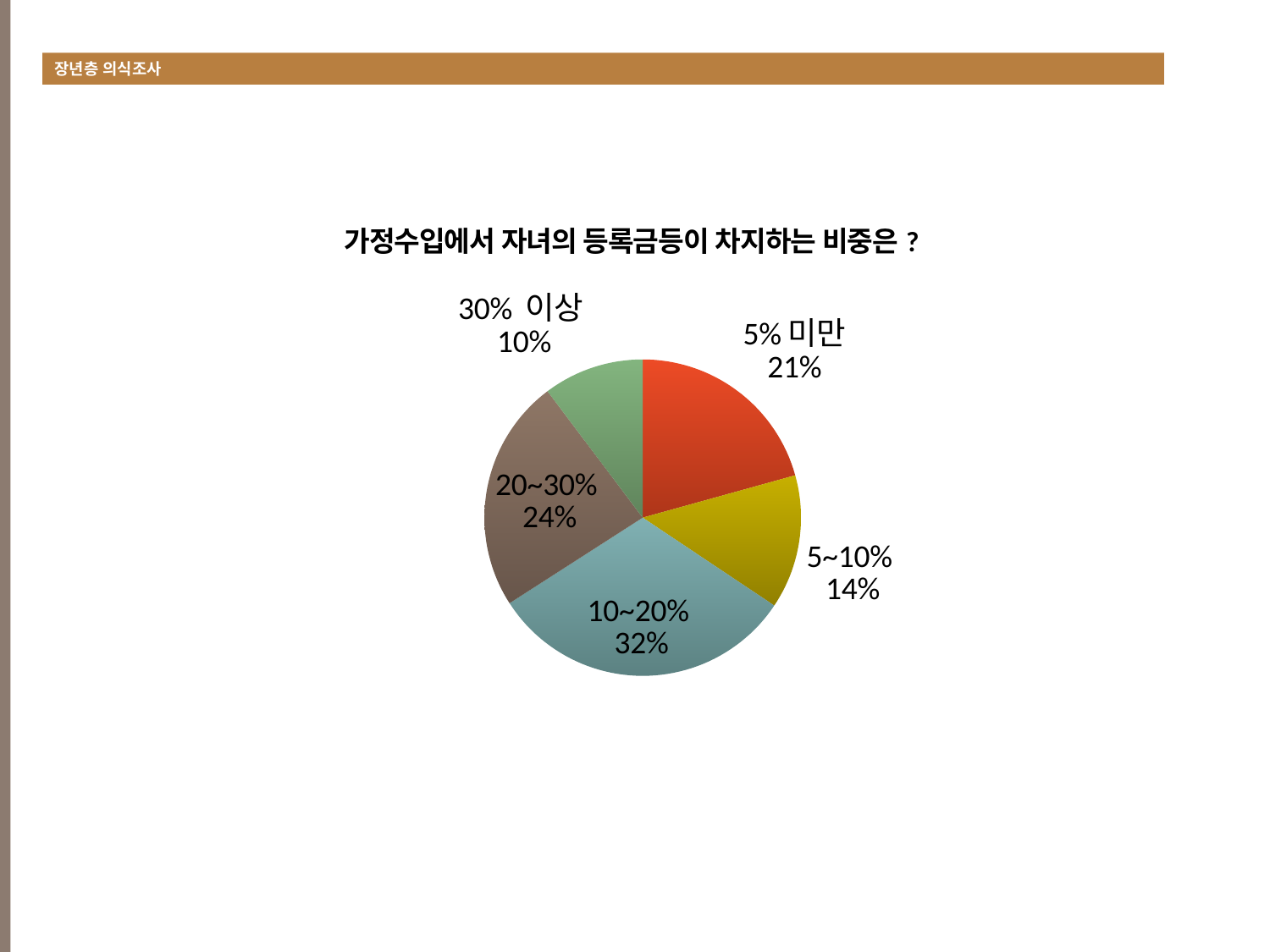
Which slice has the smallest share? 30% 이상 What is the value for the 5% 미만 slice? 21% What is the title of the chart? 가정수입에서 자녀의 등록금등이 차지하는 비중은 ? What is the value for the 10~20% slice? 32% What is the value for the 20~30% slice? 24% Which is larger, the 20~30% slice or the 5% 미만 slice? 20~30% What kind of chart is shown on the slide? pie chart What is the value for the 30% 이상 slice? 10% How many slices does the pie chart have? 5 What colour is the 10~20% slice? teal Which slice has the largest share? 10~20% What is the difference between the 10~20% slice and the 5~10% slice? 18%